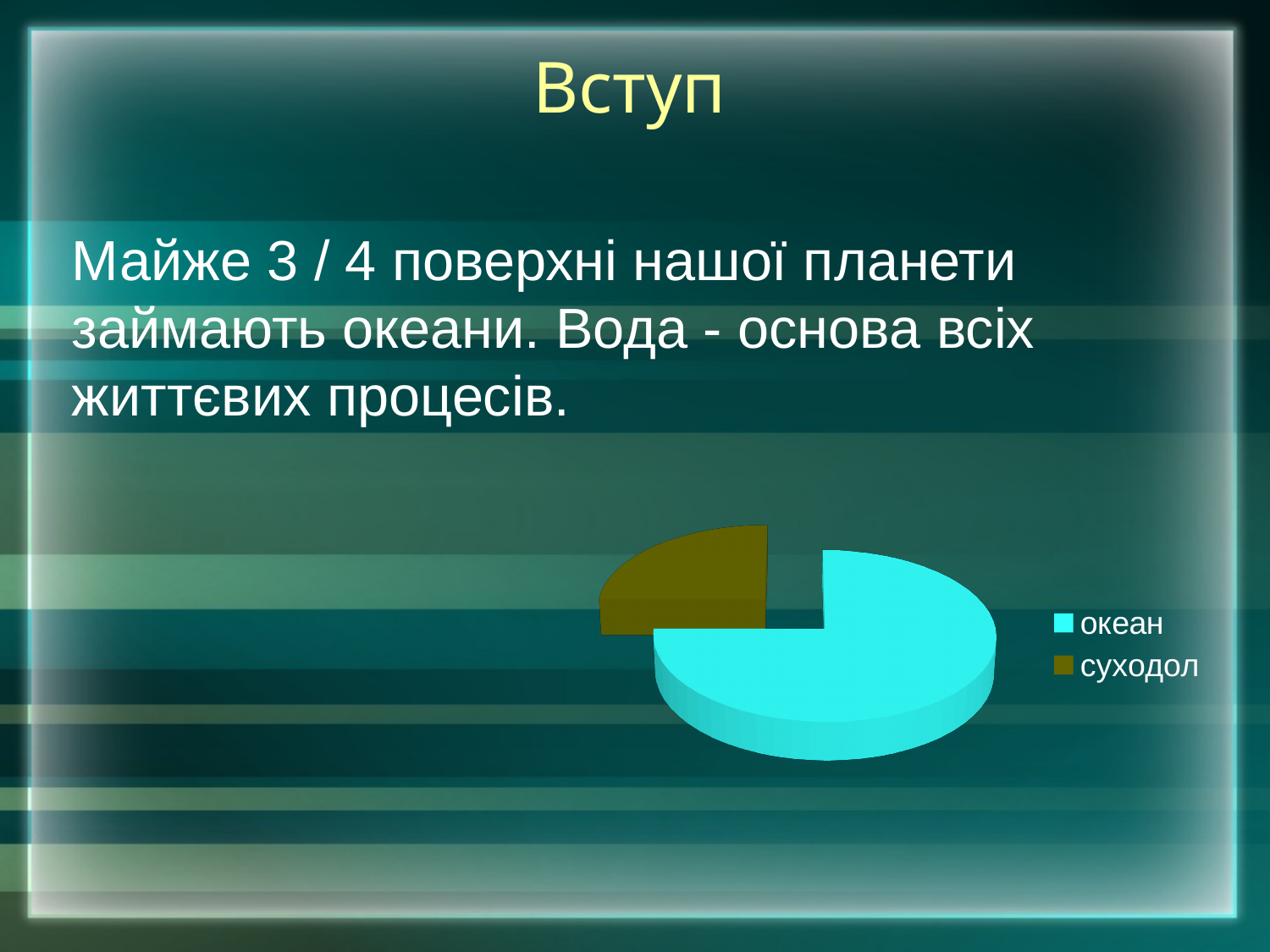
Which slice of the pie chart is the largest? океан Which slice of the pie chart is the smallest? суходол What kind of chart is shown on the slide? pie chart Which is larger in the pie chart, океан or суходол? океан How many entries does the legend of the pie chart list? 2 What colour is the океан slice in the pie chart? cyan How many slices does the pie chart have? 2 Which legend entry is shown in olive/brown in the pie chart? суходол